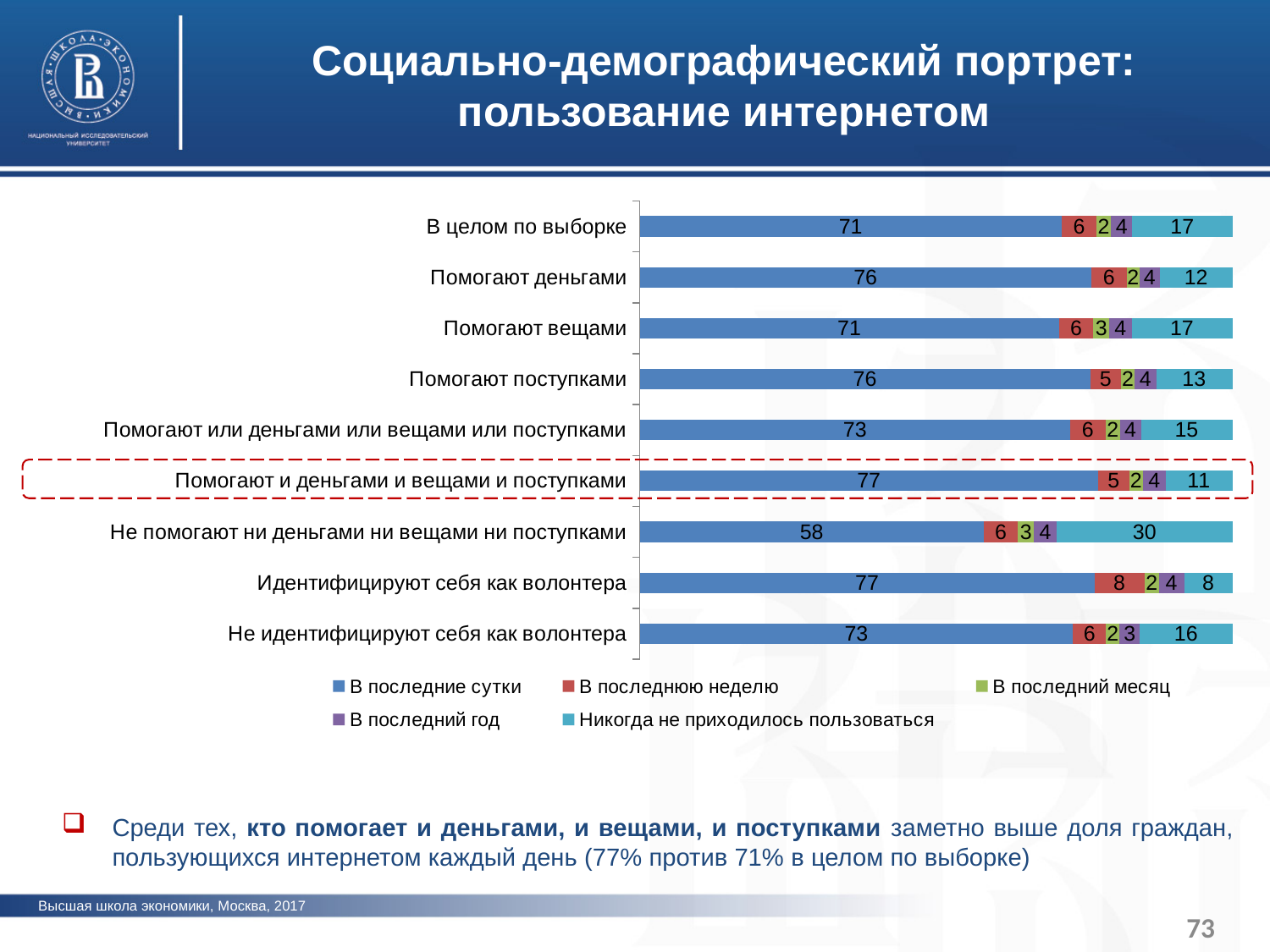
Which category has the lowest value for 'В последние сутки'? Не помогают ни деньгами ни вещами ни поступками Which category has the highest value for 'Никогда не приходилось пользоваться'? Не помогают ни деньгами ни вещами ни поступками Which category has the lowest value for 'Никогда не приходилось пользоваться'? Идентифицируют себя как волонтера What is the value of 'В последнюю неделю' for 'Идентифицируют себя как волонтера'? 8 How many categories are plotted on the chart? 9 What is the difference between the 'В последние сутки' values for 'Помогают и деньгами и вещами и поступками' and 'В целом по выборке'? 6 Which is larger: the 'В последние сутки' value for 'Помогают деньгами' or for 'Помогают вещами'? Помогают деньгами What is the value of 'В последние сутки' for 'В целом по выборке'? 71 What is the value of 'Никогда не приходилось пользоваться' for 'Не помогают ни деньгами ни вещами ни поступками'? 30 How many series does the legend list? 5 What kind of chart is shown on the slide? Stacked bar chart Which category is highlighted with a dashed red outline on the chart? Помогают и деньгами и вещами и поступками